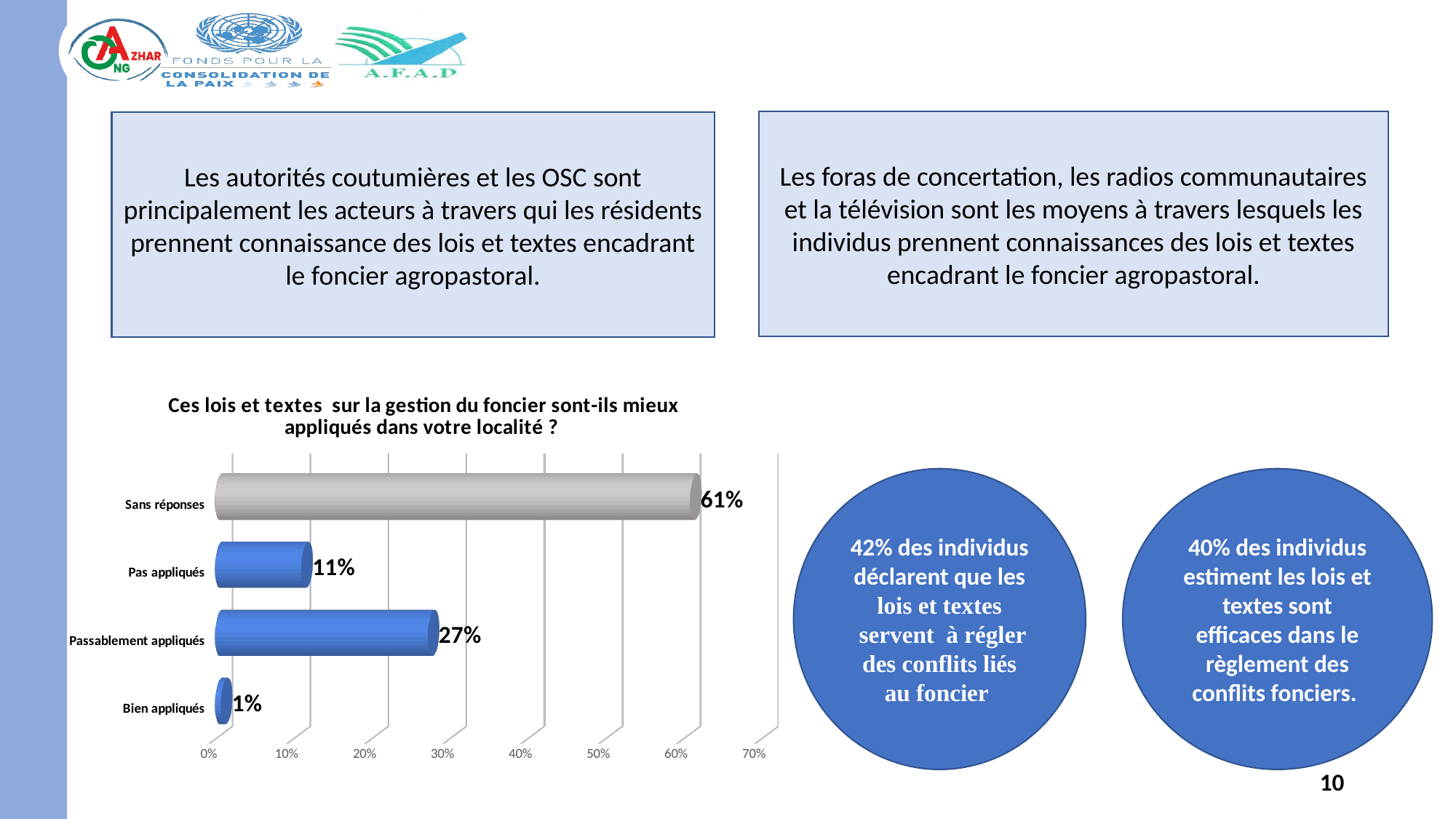
What is the value for "Passablement appliqués"? 27% What kind of chart is shown on the slide? bar chart Which category has the lowest value? Bien appliqués What is the value for "Sans réponses"? 61% What is the value for "Pas appliqués"? 11% What is the value for "Bien appliqués"? 1% What is the title of the chart? Ces lois et textes sur la gestion du foncier sont-ils mieux appliqués dans votre localité ? Which category has the highest value? Sans réponses How many categories are shown in the chart? 4 What is the difference between "Passablement appliqués" and "Pas appliqués"? 16% Is the value for "Sans réponses" greater or less than 50%? greater Which is larger, "Pas appliqués" or "Passablement appliqués"? Passablement appliqués